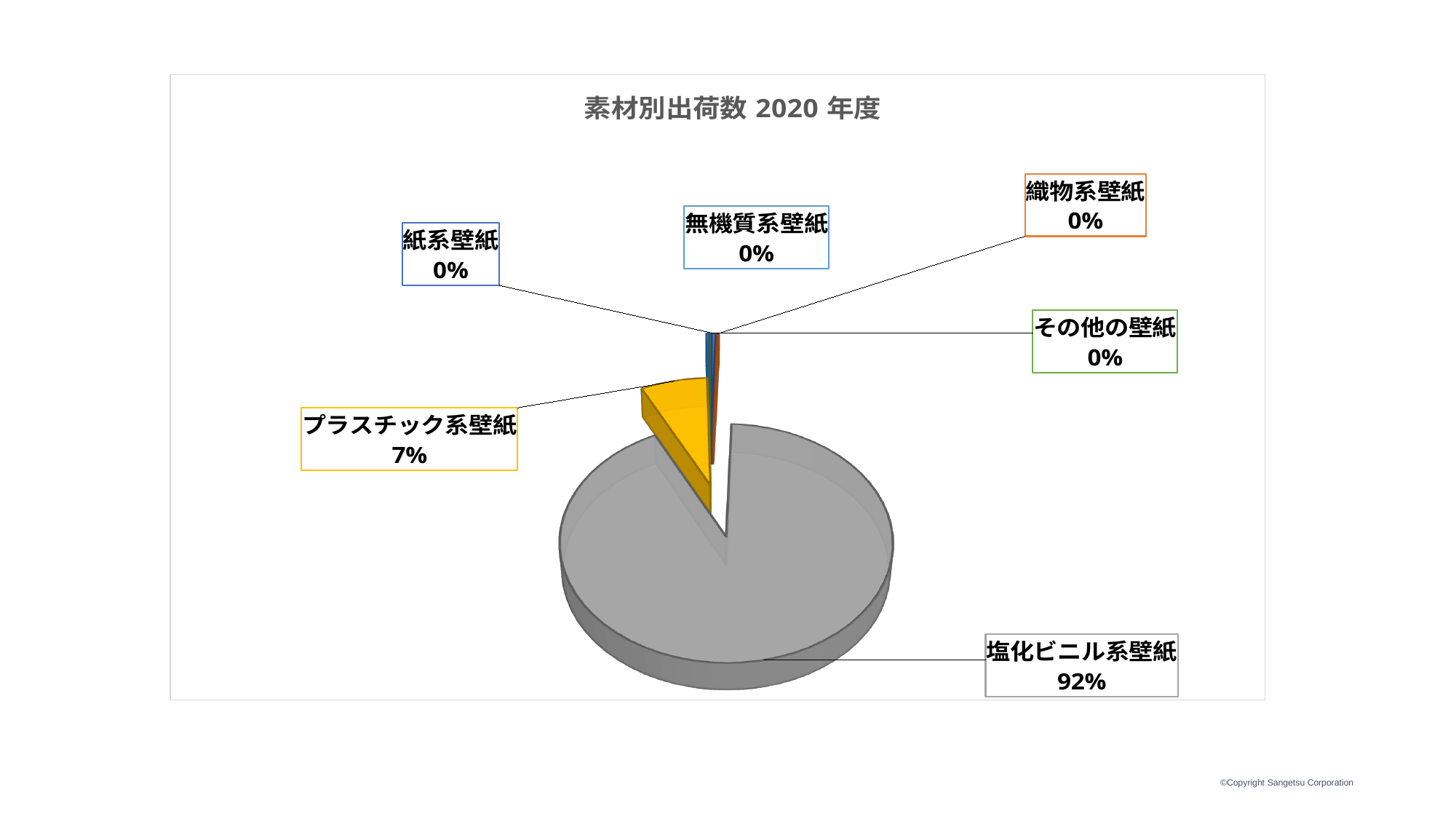
What kind of chart is shown on the slide? Pie chart What is the title of the chart? 素材別出荷数 2020 年度 What is the difference in percentage points between 塩化ビニル系壁紙 and プラスチック系壁紙? 85 What share of the pie does プラスチック系壁紙 have? 7% What percentage is shown for 紙系壁紙? 0% What share of the pie does 塩化ビニル系壁紙 have? 92% Which category has the largest share of the pie? 塩化ビニル系壁紙 Which is larger, the share for プラスチック系壁紙 or the share for 塩化ビニル系壁紙? 塩化ビニル系壁紙 How many categories are labelled on the pie chart? 6 What percentage is shown for その他の壁紙? 0% What percentage is shown for 織物系壁紙? 0% What percentage is shown for 無機質系壁紙? 0%